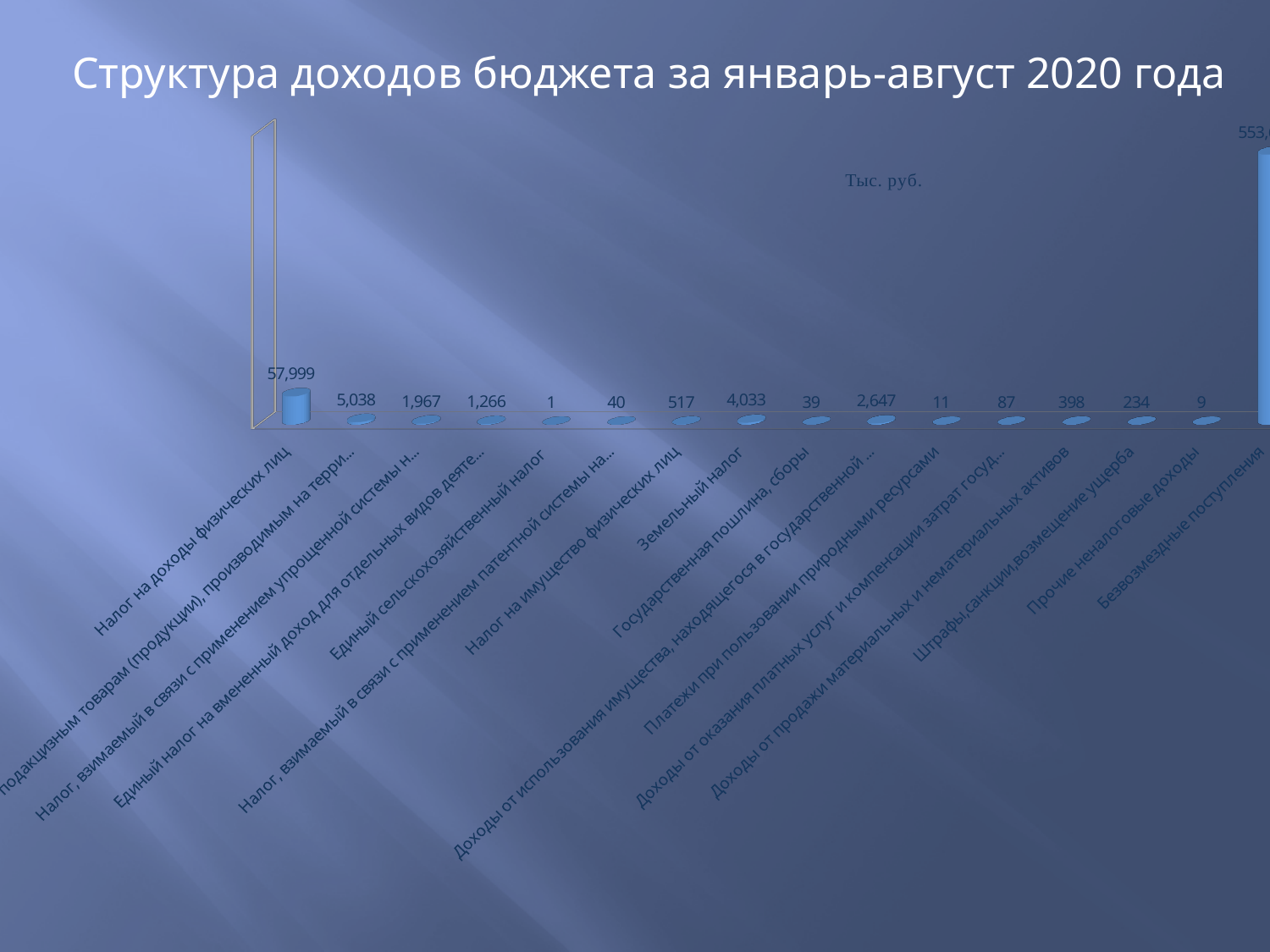
What is the value for Прочие неналоговые доходы? 9 What is the value for Государственная пошлина, сборы? 39 Which category has the lowest value? Единый сельскохозяйственный налог Which is larger: Штрафы,санкции,возмещение ущерба or Платежи при пользовании природными ресурсами? Штрафы,санкции,возмещение ущерба What is the value for Платежи при пользовании природными ресурсами? 11 What kind of chart is shown on the slide? Bar chart What is the difference between Земельный налог and Налог на имущество физических лиц? 3,516 What is the value for Налог на имущество физических лиц? 517 What is the value for Земельный налог? 4,033 Which category has the highest value? Безвозмездные поступления How many categories are shown in the chart? 16 What is the value for Налог на доходы физических лиц? 57,999